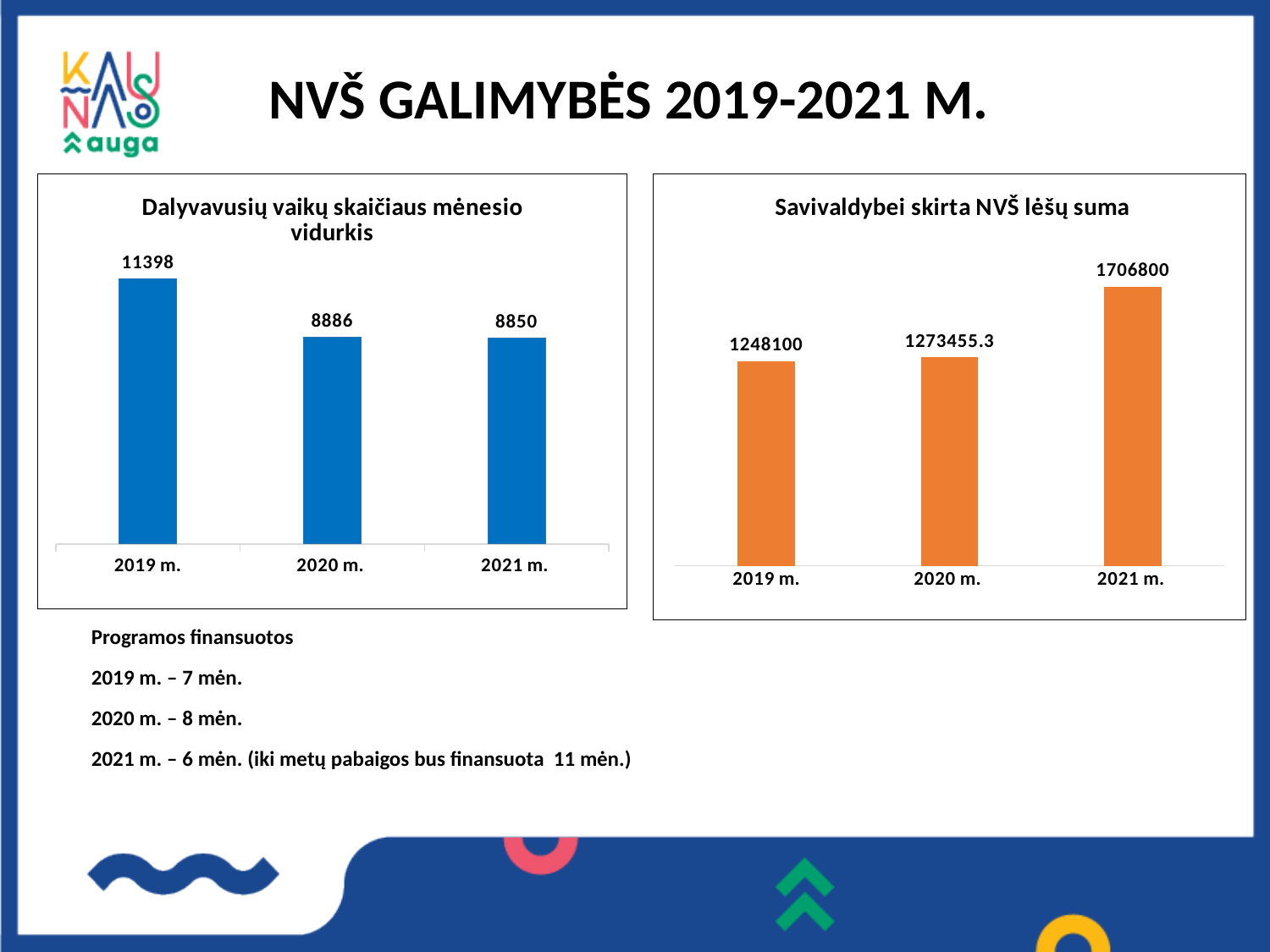
In the chart titled "Savivaldybei skirta NVŠ lėšų suma", which is larger, the value for 2021 m. or the value for 2020 m.? 2021 m. In the chart titled "Savivaldybei skirta NVŠ lėšų suma", which year has the lowest value? 2019 m. In the chart titled "Dalyvavusių vaikų skaičiaus mėnesio vidurkis", which year has the highest value? 2019 m. In the chart titled "Savivaldybei skirta NVŠ lėšų suma", what is the value for 2021 m.? 1706800 In the chart titled "Dalyvavusių vaikų skaičiaus mėnesio vidurkis", what is the value for 2019 m.? 11398 In the chart titled "Savivaldybei skirta NVŠ lėšų suma", what is the value for 2020 m.? 1273455.3 In the chart titled "Dalyvavusių vaikų skaičiaus mėnesio vidurkis", what is the difference between the values for 2019 m. and 2020 m.? 2512 In the chart titled "Savivaldybei skirta NVŠ lėšų suma", what is the difference between the values for 2021 m. and 2019 m.? 458700 In the chart titled "Dalyvavusių vaikų skaičiaus mėnesio vidurkis", do the values rise or fall from 2019 m. to 2021 m.? fall In the chart titled "Dalyvavusių vaikų skaičiaus mėnesio vidurkis", what is the value for 2021 m.? 8850 How many categories are shown in the chart titled "Savivaldybei skirta NVŠ lėšų suma"? 3 What kind of chart is the chart on the left of the slide? bar chart